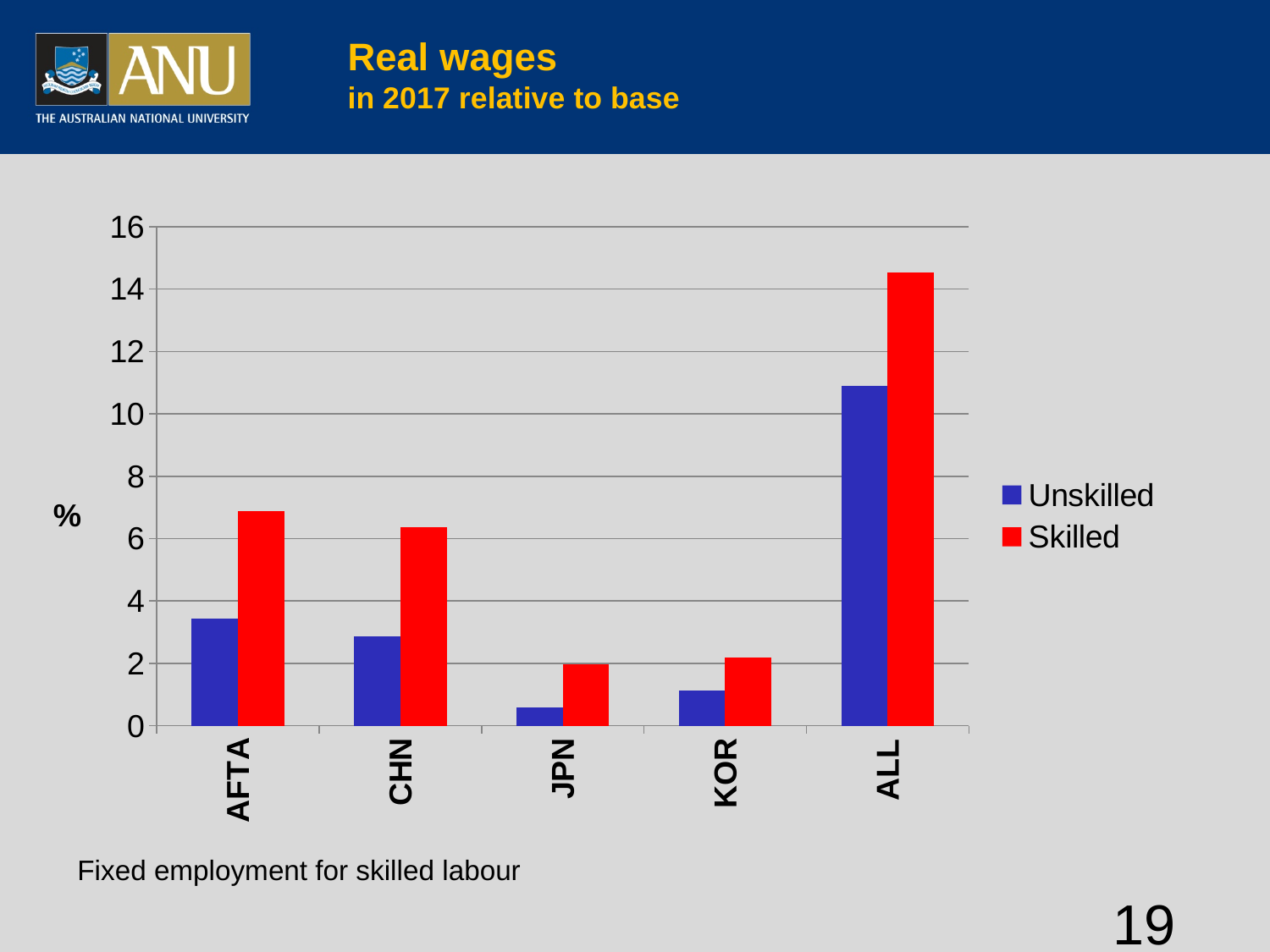
Which category has the highest Skilled value? ALL For CHN, which is larger: the Skilled value or the Unskilled value? Skilled Is the Skilled value for ALL greater or less than 12? greater Which category has the lowest Unskilled value? JPN How many categories are shown on the x axis of the chart? 5 How many series does the legend list? 2 Which is larger: the Unskilled value for AFTA or the Unskilled value for KOR? AFTA Is the Unskilled value for ALL greater or less than 10? greater Is the Skilled value for JPN greater or less than 4? less Which category has the highest Unskilled value? ALL What label is shown on the y axis of the chart? % What kind of chart is shown on the slide? bar chart